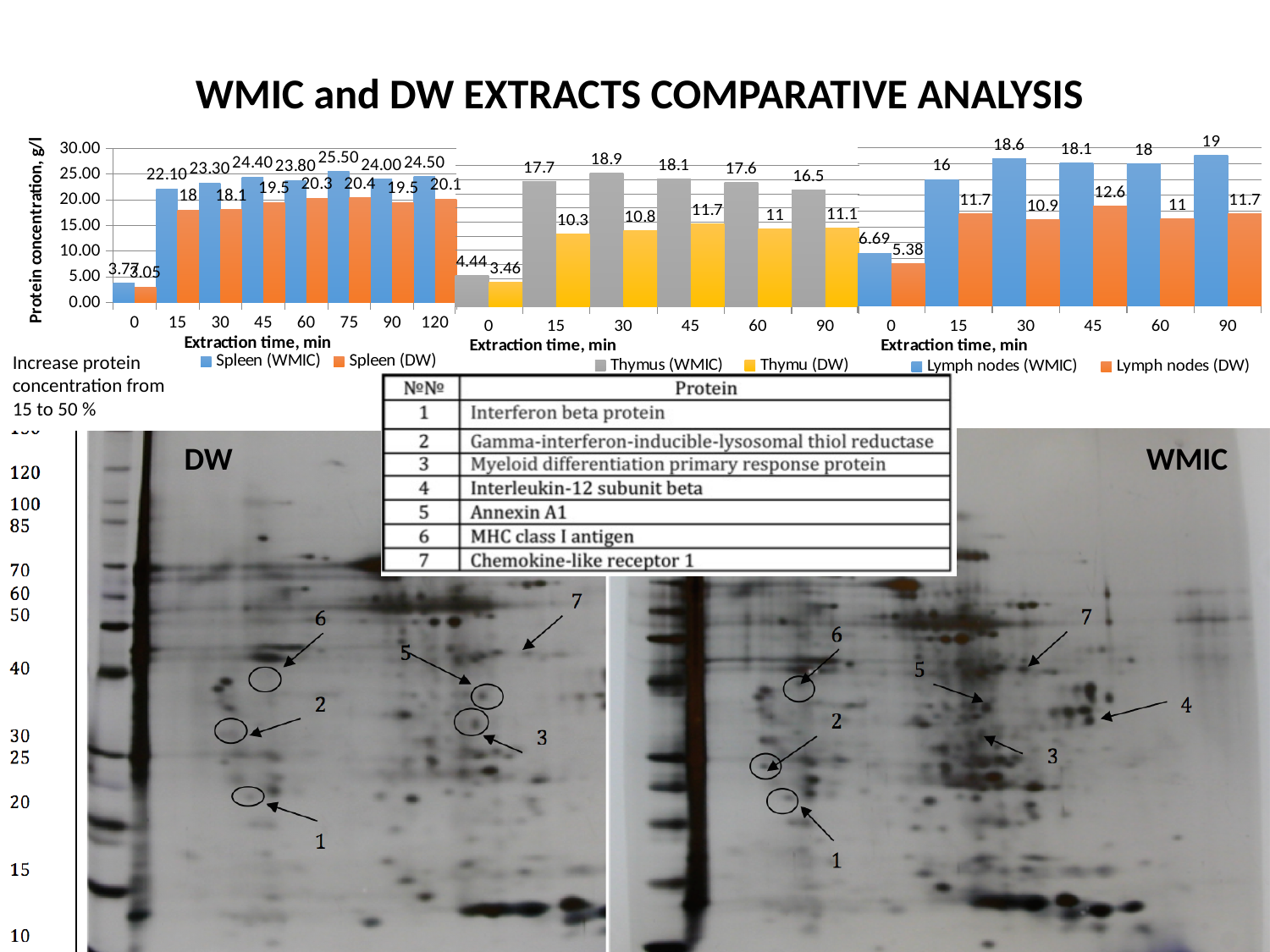
In the left chart (Spleen), what is the Spleen (WMIC) protein concentration at 75 min extraction time? 25.50 In the left chart (Spleen), at which extraction time is the Spleen (WMIC) value highest? 75 In the left chart (Spleen), what is the Spleen (DW) value at 60 min? 20.3 In the right chart (Lymph nodes), which is larger at 45 min: Lymph nodes (WMIC) or Lymph nodes (DW)? Lymph nodes (WMIC) In the right chart (Lymph nodes), what is the difference between Lymph nodes (WMIC) and Lymph nodes (DW) at 30 min? 7.7 What type of chart is used for the Lymph nodes data on the right? Bar chart In the middle chart (Thymus), what is the Thymu (DW) value at 0 min? 3.46 In the middle chart (Thymus), at which extraction time is the Thymu (DW) value lowest? 0 In the left chart (Spleen), what is the difference between Spleen (WMIC) and Spleen (DW) at 15 min? 4.10 In the right chart (Lymph nodes), what is the Lymph nodes (WMIC) value at 90 min? 19 How many extraction time categories are shown on the x axis of the left chart (Spleen)? 8 In the middle chart (Thymus), what is the Thymus (WMIC) value at 30 min? 18.9